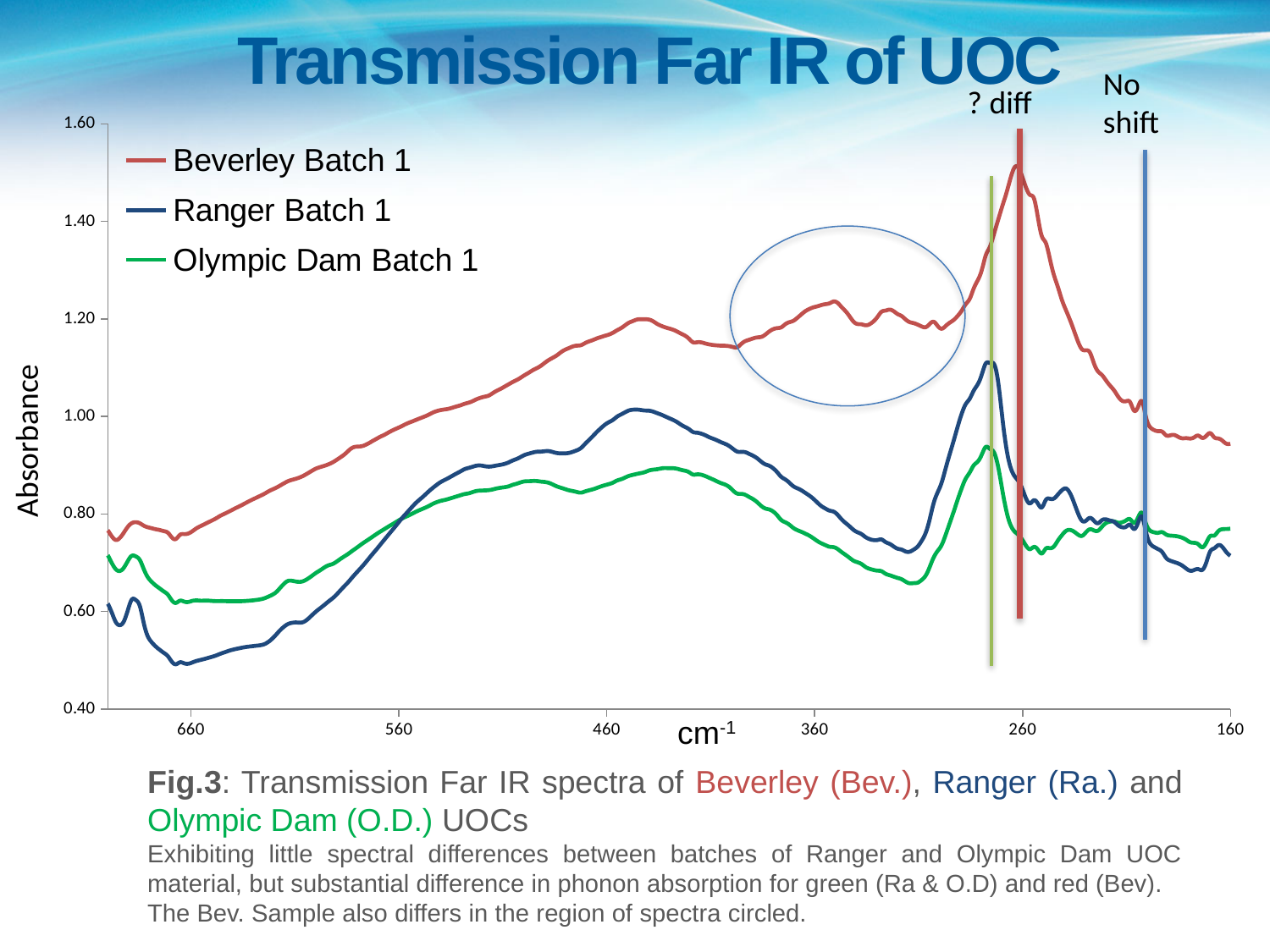
What kind of chart is shown on the slide? Line chart What is the label of the y axis? Absorbance Is the absorbance of Ranger Batch 1 at 660 cm-1 greater or less than 0.60? less Is the peak absorbance of Ranger Batch 1 near 270 cm-1 greater or less than 1.00? greater Does the absorbance of Beverley Batch 1 rise or fall between 660 cm-1 and 460 cm-1? rise Which series reaches the highest absorbance on the chart? Beverley Batch 1 How many series does the legend list? 3 What is the title of the chart? Transmission Far IR of UOC Which series has the lowest absorbance at 660 cm-1? Ranger Batch 1 Is the peak absorbance of Olympic Dam Batch 1 near 270 cm-1 greater or less than 1.00? less Which series has the higher absorbance at 460 cm-1, Beverley Batch 1 or Olympic Dam Batch 1? Beverley Batch 1